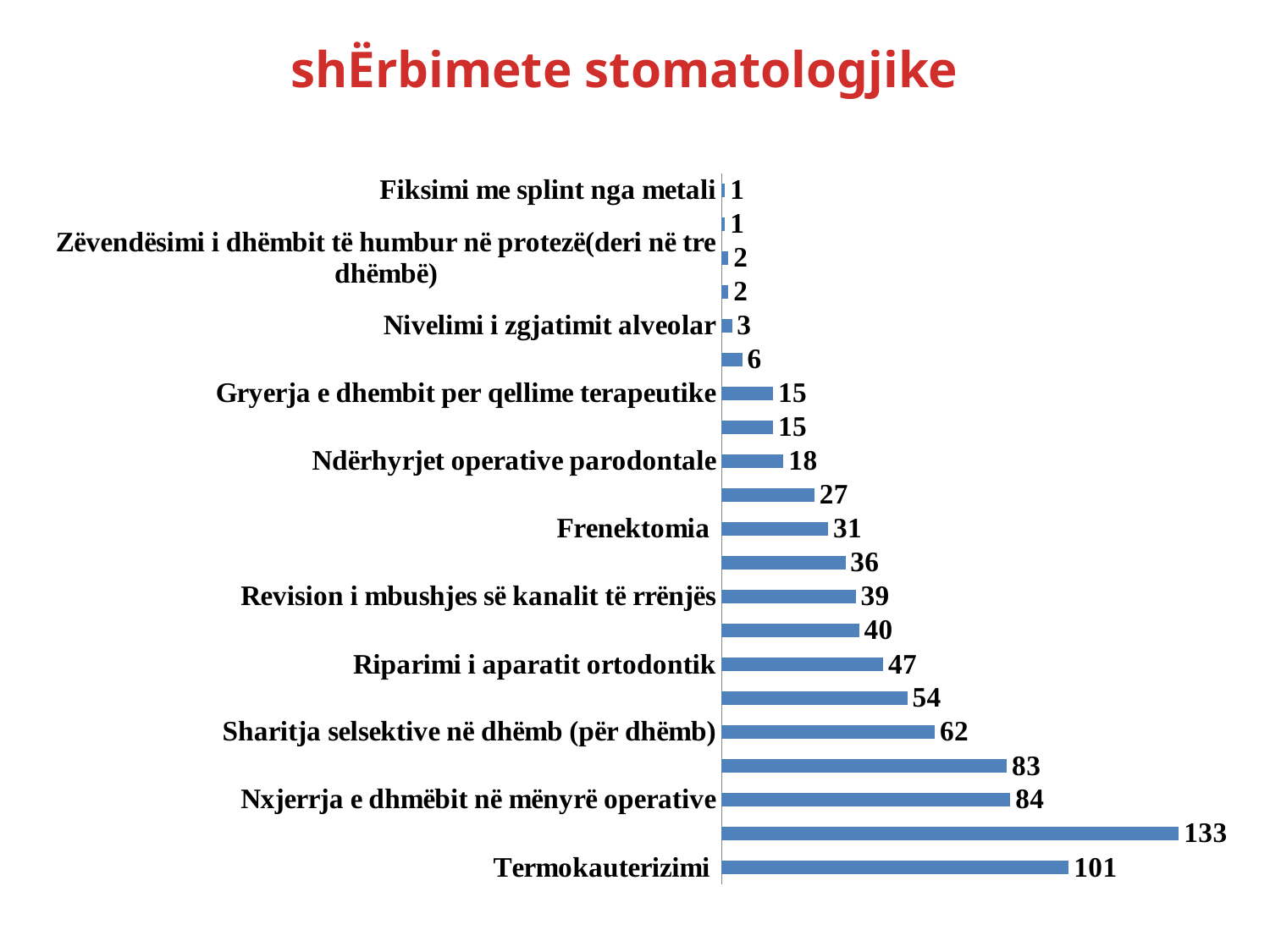
What is the value for Riparimi i aparatit ortodontik? 47 Which is larger, Revision i mbushjes së kanalit të rrënjës or Ndërhyrjet operative parodontale? Revision i mbushjes së kanalit të rrënjës What kind of chart is shown on the slide? Bar chart What is the difference between the values for Termokauterizimi and Nxjerrja e dhmëbit në mënyrë operative? 17 What is the value for Sharitja selsektive në dhëmb (për dhëmb)? 62 What is the value for Frenektomia? 31 What is the value for Fiksimi me splint nga metali, the smallest labelled category? 1 What is the value for Termokauterizimi? 101 What is the largest value shown on the chart? 133 What is the title of the slide? shËrbimete stomatologjike What is the value for Nivelimi i zgjatimit alveolar? 3 What is the value for Nxjerrja e dhmëbit në mënyrë operative? 84